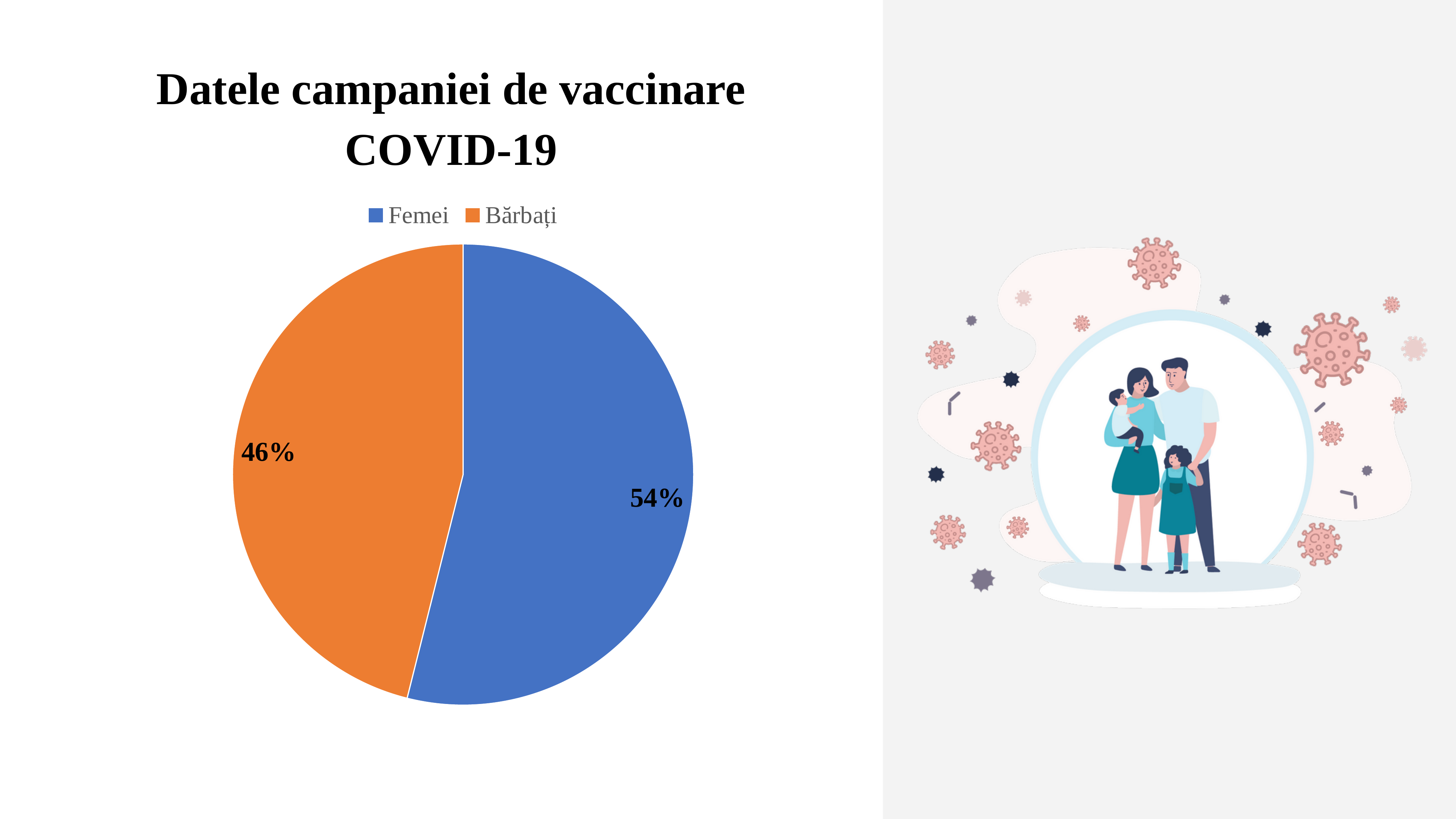
Which category has the smallest slice of the pie? Bărbați What kind of chart is shown on the slide? pie chart Which is larger, the Femei slice or the Bărbați slice? Femei What share of the pie does Bărbați have? 46% What is the title of the chart? Datele campaniei de vaccinare COVID-19 What is the difference in percentage points between the Femei and Bărbați slices? 8 How many entries does the legend list? 2 What share of the pie does Femei have? 54% How many slices does the pie chart have? 2 What colour is the Bărbați slice? orange Which category has the largest slice of the pie? Femei